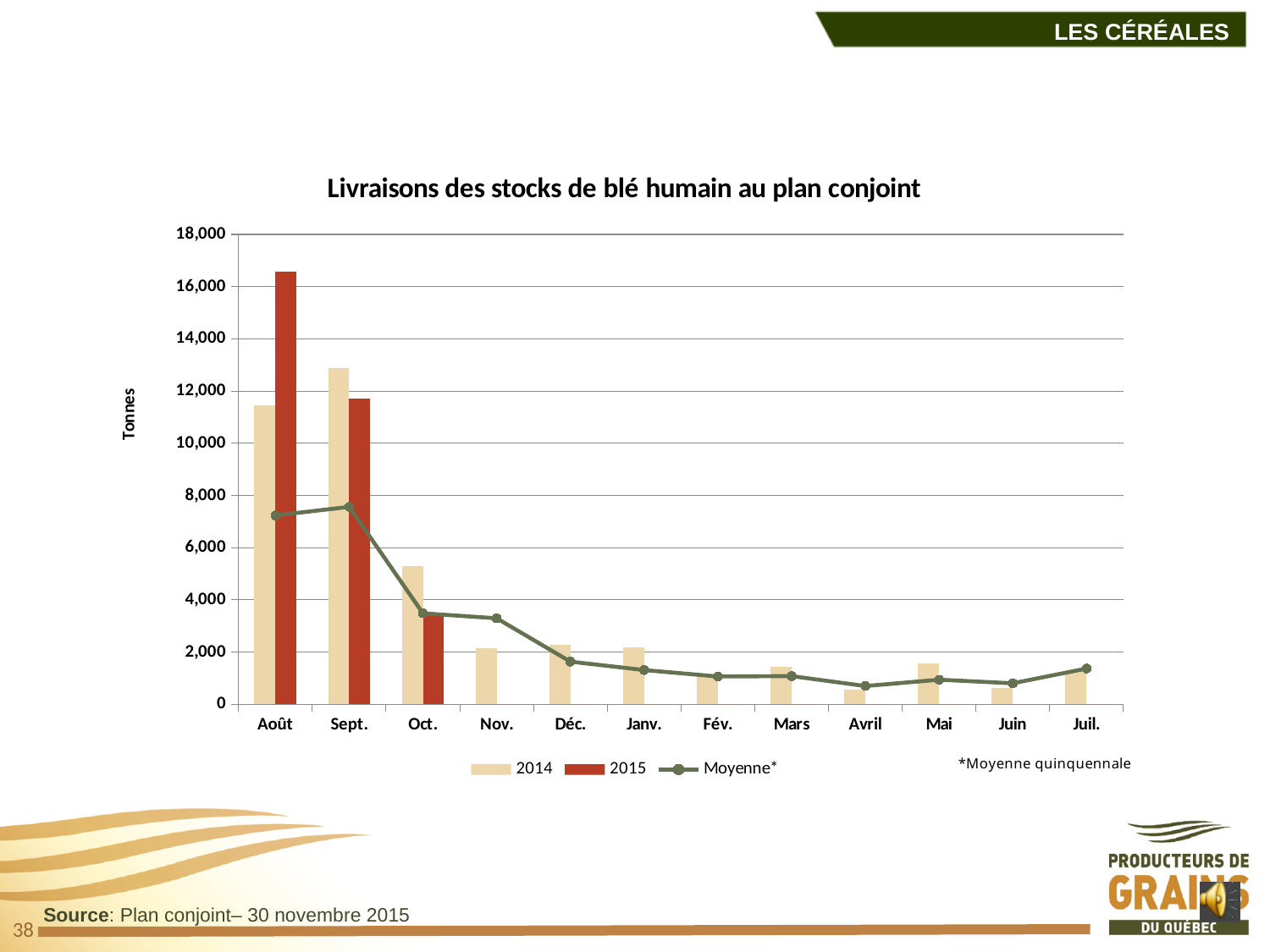
Is the 2015 value for Oct. greater or less than 4,000? less How many months are shown on the x axis? 12 Does the Moyenne* line rise or fall from Août to Avril? fall How many series does the legend list? 3 What kind of chart is shown on the slide? A bar chart combined with a line For Sept., which is larger: the 2014 bar or the 2015 bar? 2014 For Août, which is larger: the 2014 bar or the 2015 bar? 2015 What is the label on the vertical axis? Tonnes In which month is the 2014 bar the highest? Sept. In which month is the 2015 bar the highest? Août Is the 2015 value for Août greater or less than 16,000? greater Is the 2014 value for Oct. greater or less than 6,000? less